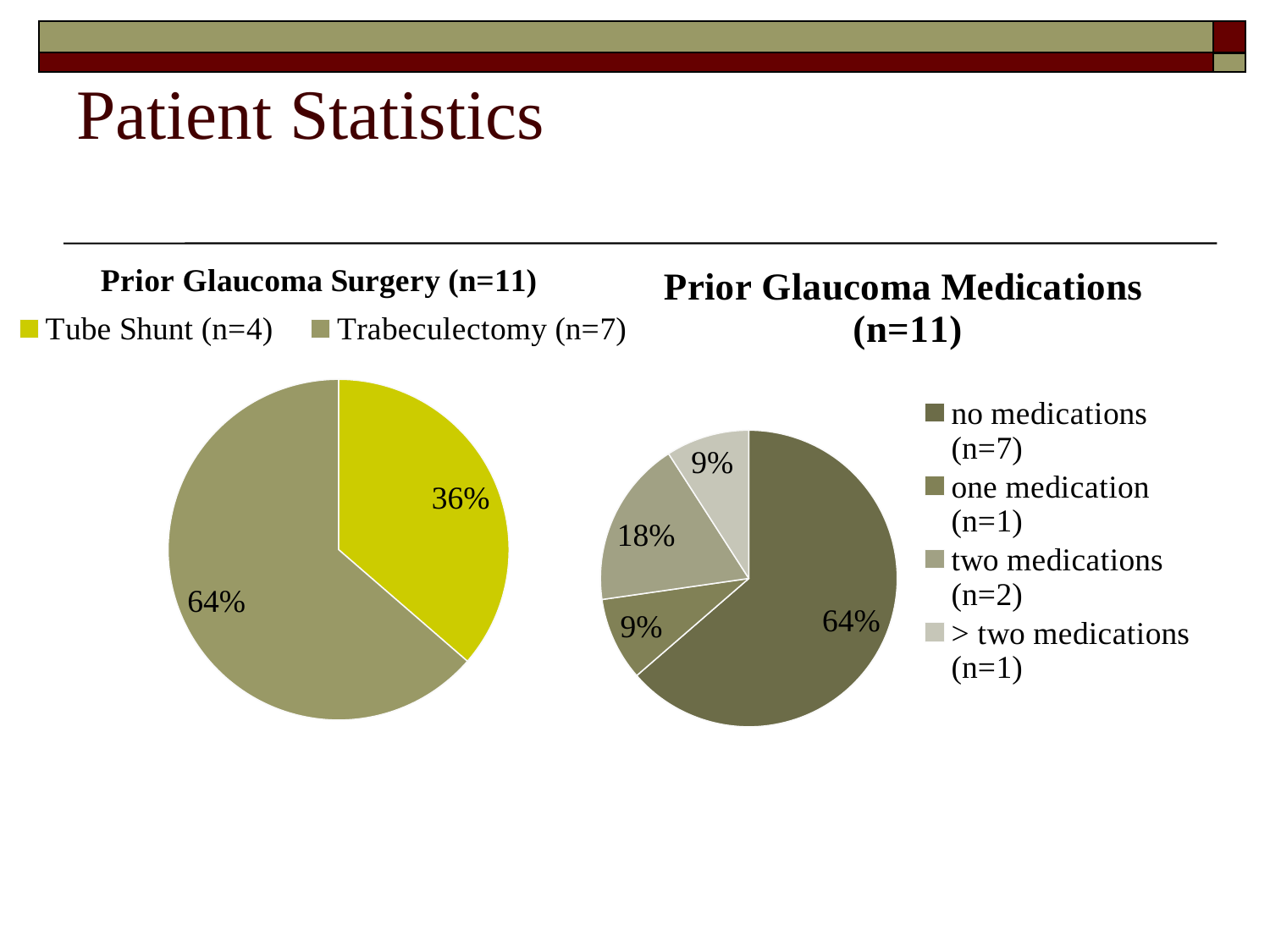
In the Prior Glaucoma Medications (n=11) chart, what share of the pie is no medications? 64% In the Prior Glaucoma Surgery (n=11) chart, what share of the pie is Tube Shunt? 36% In the Prior Glaucoma Surgery (n=11) chart, how many slices does the pie have? 2 What kind of chart is the Prior Glaucoma Surgery (n=11) chart? pie chart In the Prior Glaucoma Medications (n=11) chart, which category has the largest slice? no medications In the Prior Glaucoma Surgery (n=11) chart, what share of the pie is Trabeculectomy? 64% In the Prior Glaucoma Surgery (n=11) chart, which category has the largest slice? Trabeculectomy In the Prior Glaucoma Medications (n=11) chart, how many categories does the legend list? 4 In the Prior Glaucoma Surgery (n=11) chart, what colour is the Tube Shunt slice? yellow In the Prior Glaucoma Surgery (n=11) chart, what is the difference in percentage points between Trabeculectomy and Tube Shunt? 28 In the Prior Glaucoma Medications (n=11) chart, which is larger: two medications or one medication? two medications